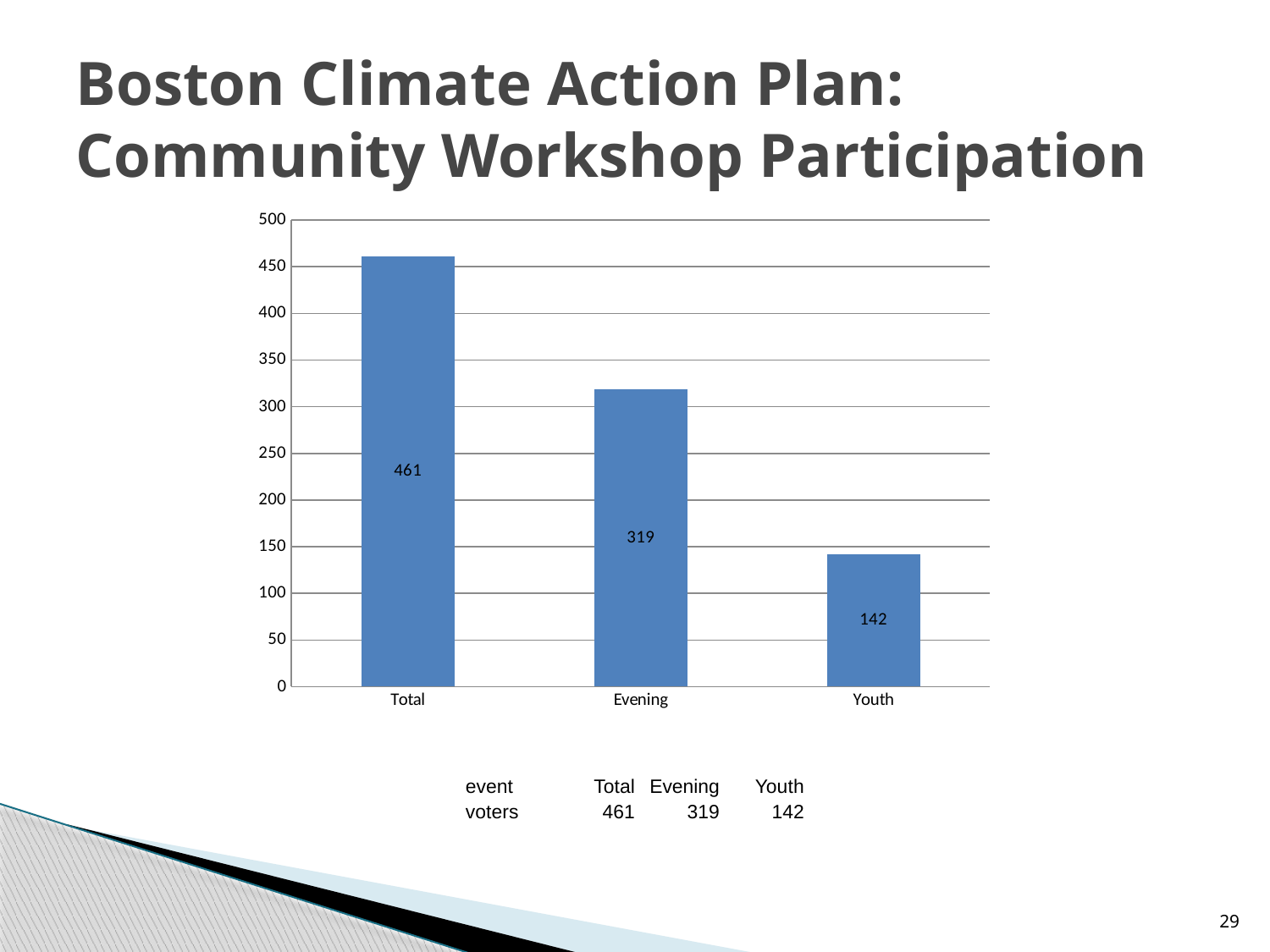
What is the value for Total? 461 Which category has the highest value? Total Which is larger, the value for Evening or the value for Youth? Evening What is the difference between the Total and Evening values? 142 What is the value for Youth? 142 Which category has the lowest value? Youth What kind of chart is shown on the slide? bar chart Is the value for Evening greater or less than 300? greater Do the values rise or fall from left to right along the x axis? fall How many categories are shown on the x axis? 3 What is the difference between the Evening and Youth values? 177 What is the value for Evening? 319